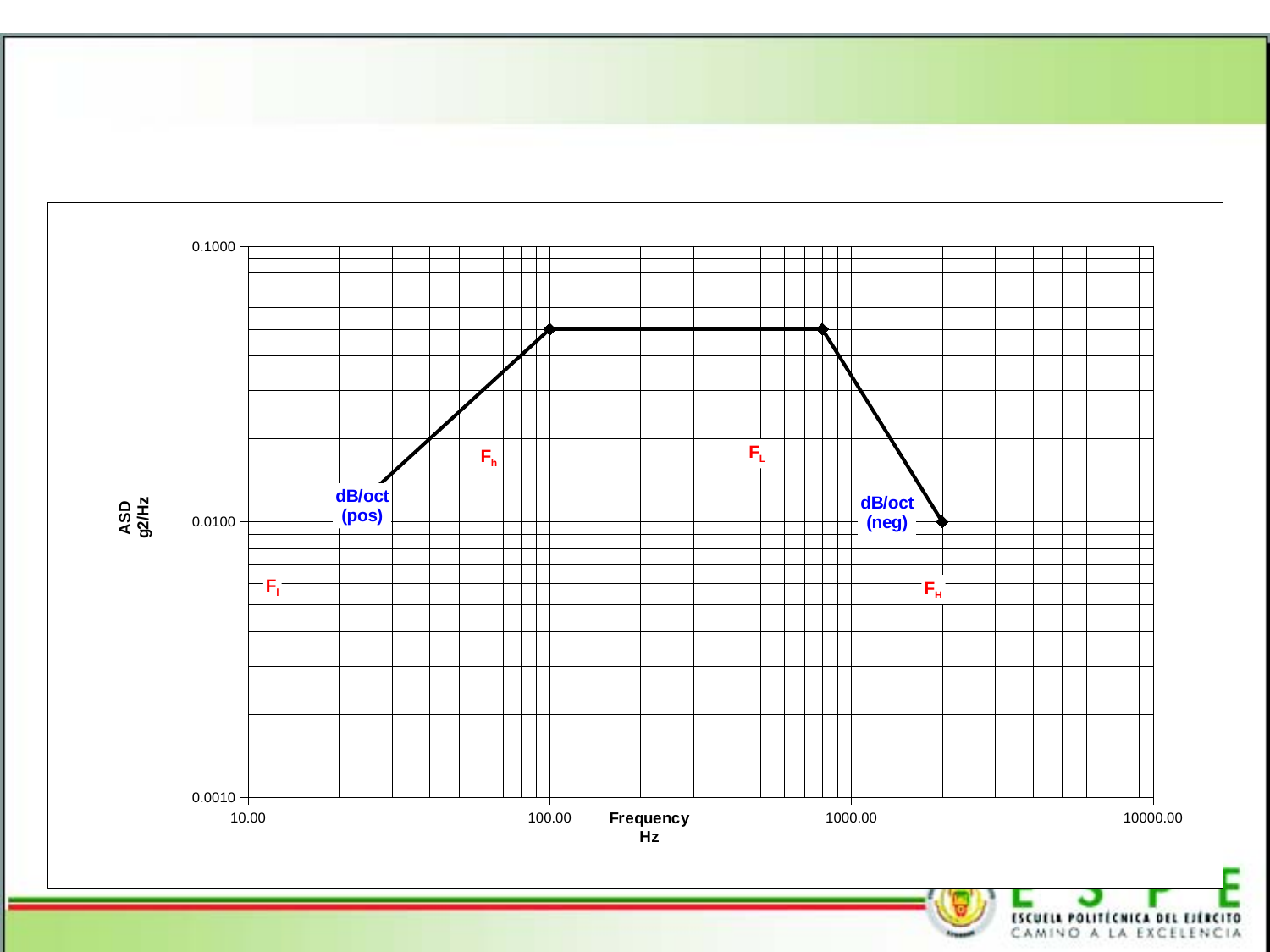
Is the value of the curve at 100.00 Hz greater or less than 0.1000? less What is the title of the y axis? ASD g2/Hz What kind of chart is shown on the slide? line chart Does the curve rise or fall as frequency increases from 1000.00 Hz toward its right end? falls Does the curve rise or fall as frequency increases from 10.00 Hz to 100.00 Hz? rises Is the value of the curve at 100.00 Hz greater or less than 0.0100? greater What is the title of the x axis? Frequency Hz Is the curve flat, rising or falling between 100.00 Hz and about 800 Hz? flat What is the lowest tick label shown on the y axis? 0.0010 Which is larger: the value of the curve at 100.00 Hz or its value at the right end of the curve near 2000 Hz? the value at 100.00 Hz